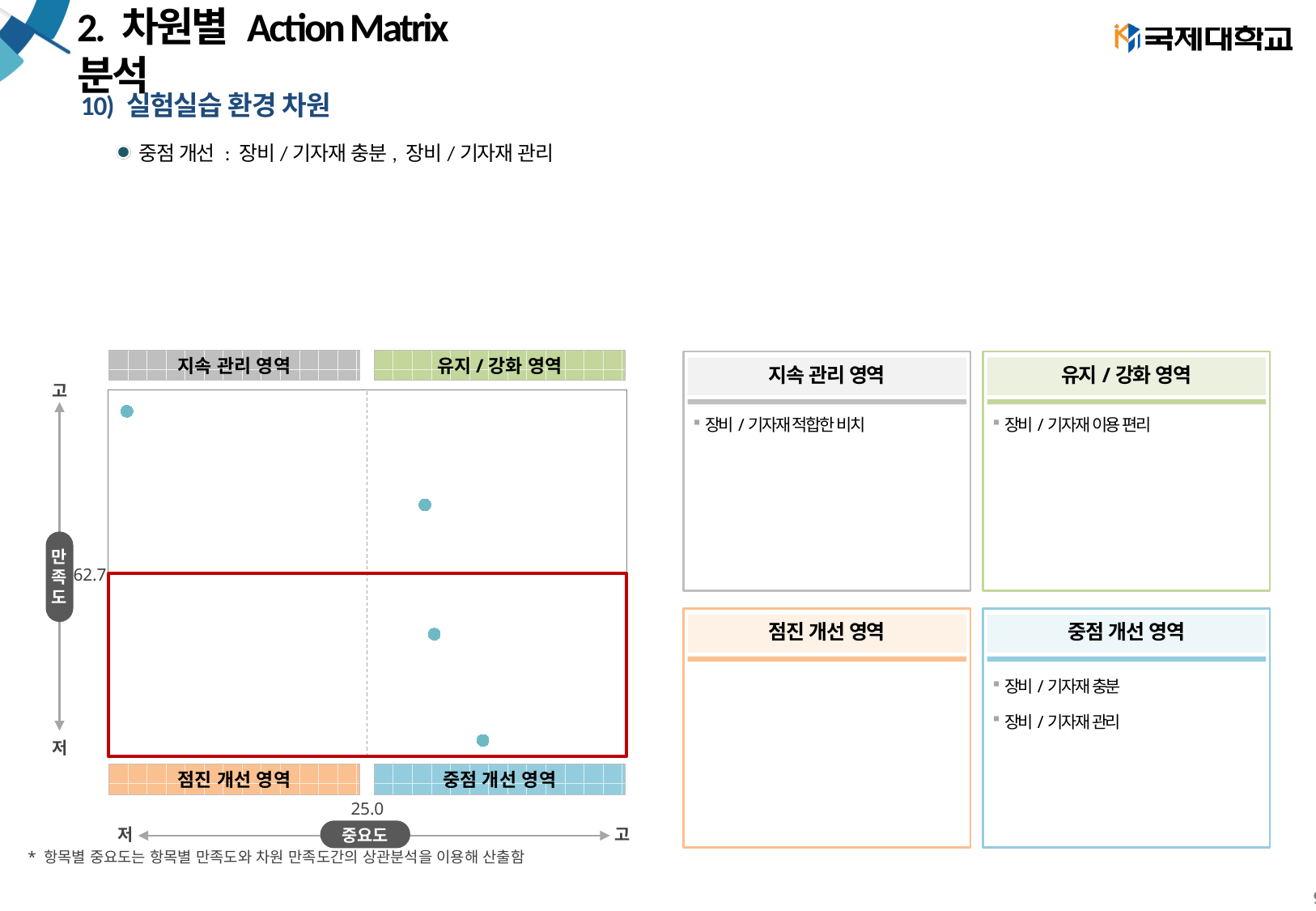
How many points in the chart fall in the 중점 개선 영역 quadrant? 2 How many points in the chart fall in the 점진 개선 영역 quadrant? 0 Which quadrant of the chart is outlined with a red box? The red box outlines the entire bottom half, covering both 점진 개선 영역 (bottom-left) and 중점 개선 영역 (bottom-right) How many points in the chart have an importance value greater than 25.0? 3 What kind of chart is shown on the left of the slide? scatter chart What value marks the vertical dividing line on the importance (중요도) axis of the chart? 25.0 Is the satisfaction value of the lowest point in the chart greater or less than 62.7? less Is the importance value of the point in the 지속 관리 영역 quadrant greater or less than 25.0? less What value marks the horizontal dividing line on the satisfaction (만족도) axis of the chart? 62.7 What label is given to the vertical axis of the chart? 만족도